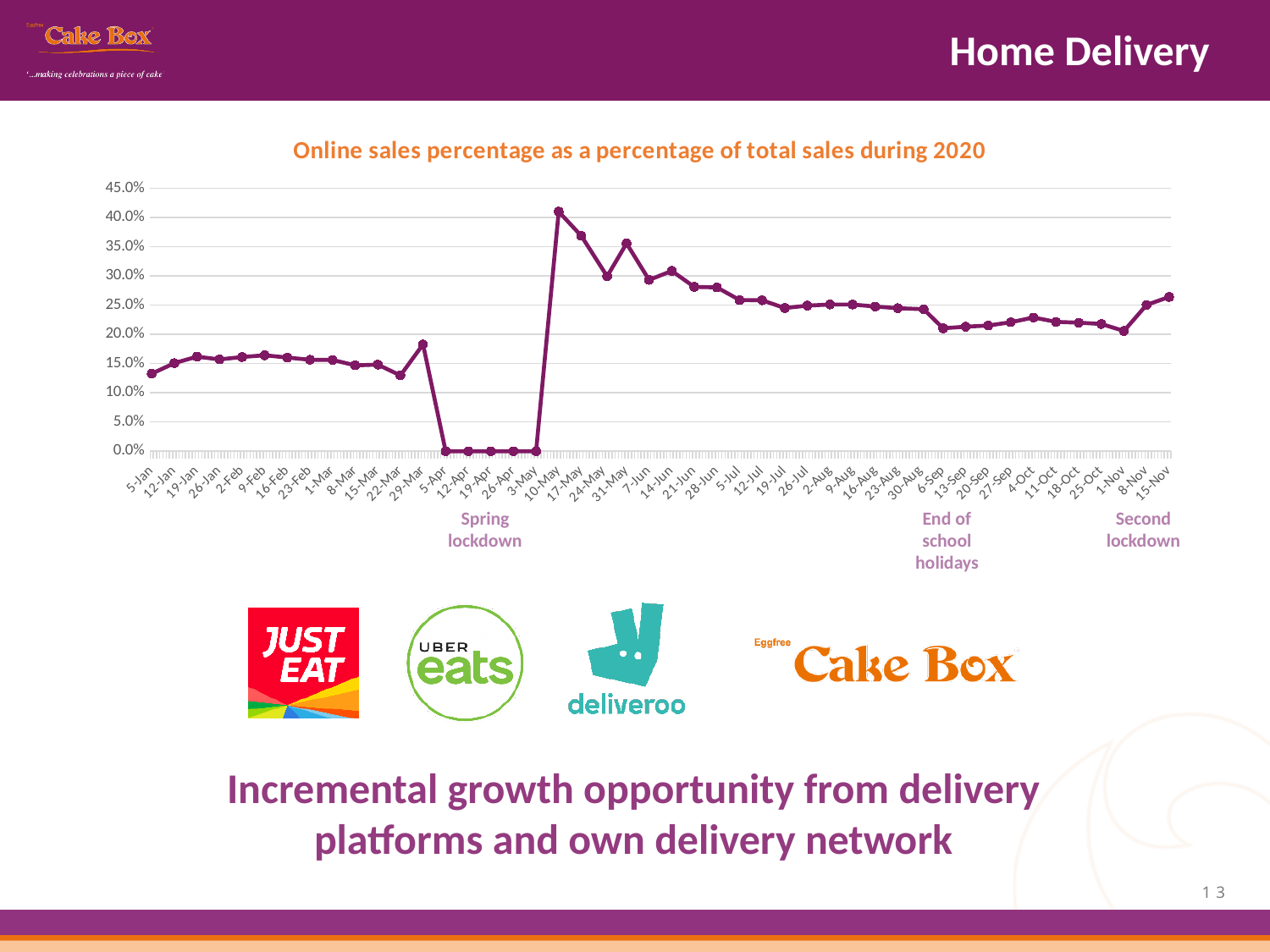
Do the values rise or fall between 10-May and 1-Nov? Fall How many dates are plotted on the x axis? 46 Is the value for 15-Nov greater or less than 25.0%? greater Is the value for 5-Jan greater or less than 15.0%? less What is the title of the chart? Online sales percentage as a percentage of total sales during 2020 What kind of chart is shown on the slide? Line chart Is the value for 29-Mar greater or less than 15.0%? greater Which date has the highest online sales percentage? 10-May Which is larger, the value for 10-May or the value for 15-Nov? 10-May What is the online sales percentage for 12-Apr? 0.0% What annotation is shown below the x axis near 5-Apr? Spring lockdown